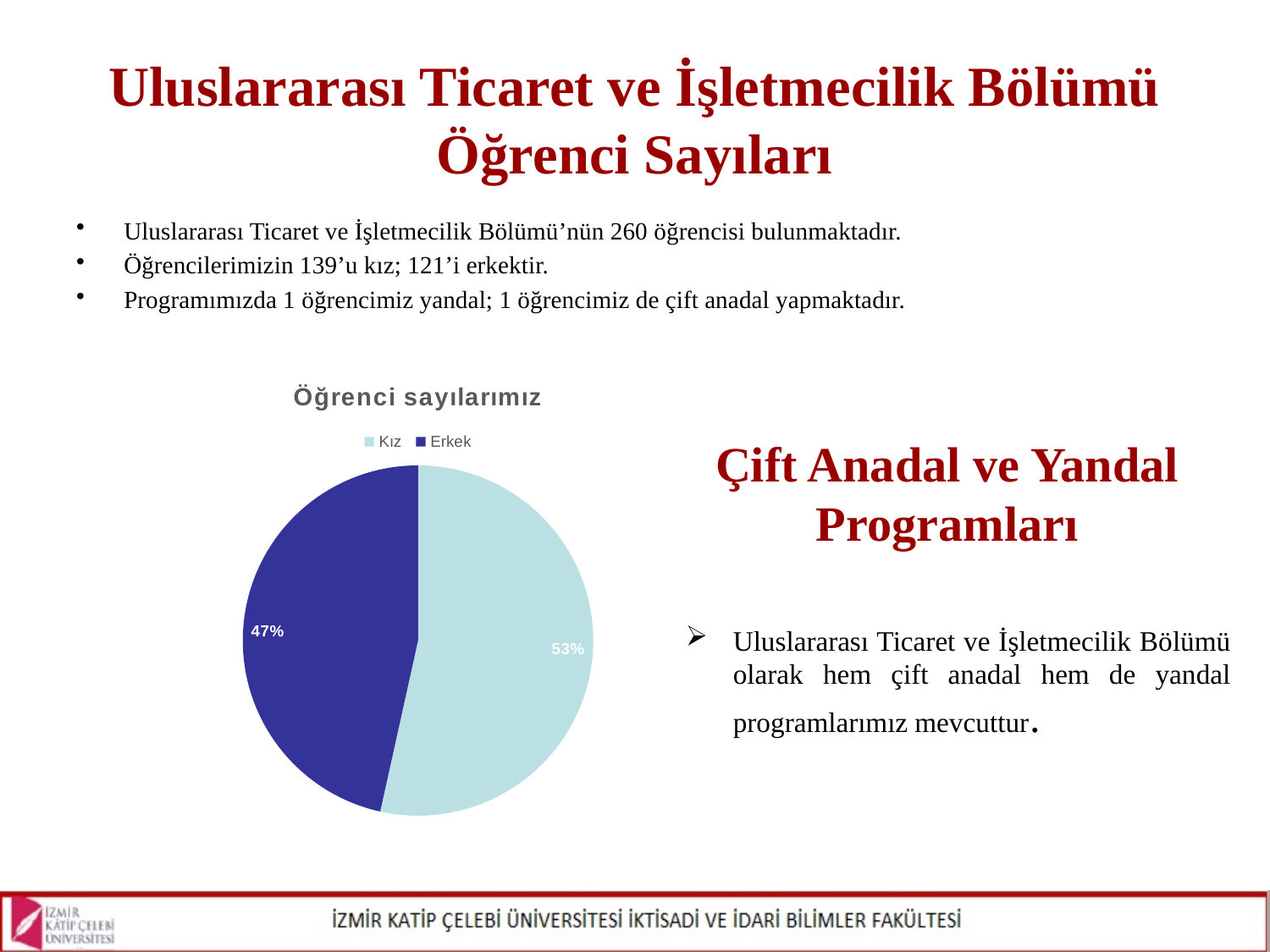
Which is larger in the pie chart, Kız or Erkek? Kız What is the title of the chart? Öğrenci sayılarımız What share of the pie does the Kız slice represent? 53% How many slices does the pie chart have? 2 How many entries does the chart legend list? 2 Which legend entry is shown in dark blue? Erkek Which slice of the pie chart is the largest? Kız Which slice of the pie chart is the smallest? Erkek What kind of chart is shown on the slide? pie chart What share of the pie does the Erkek slice represent? 47% What is the difference in percentage points between the Kız and Erkek slices? 6%